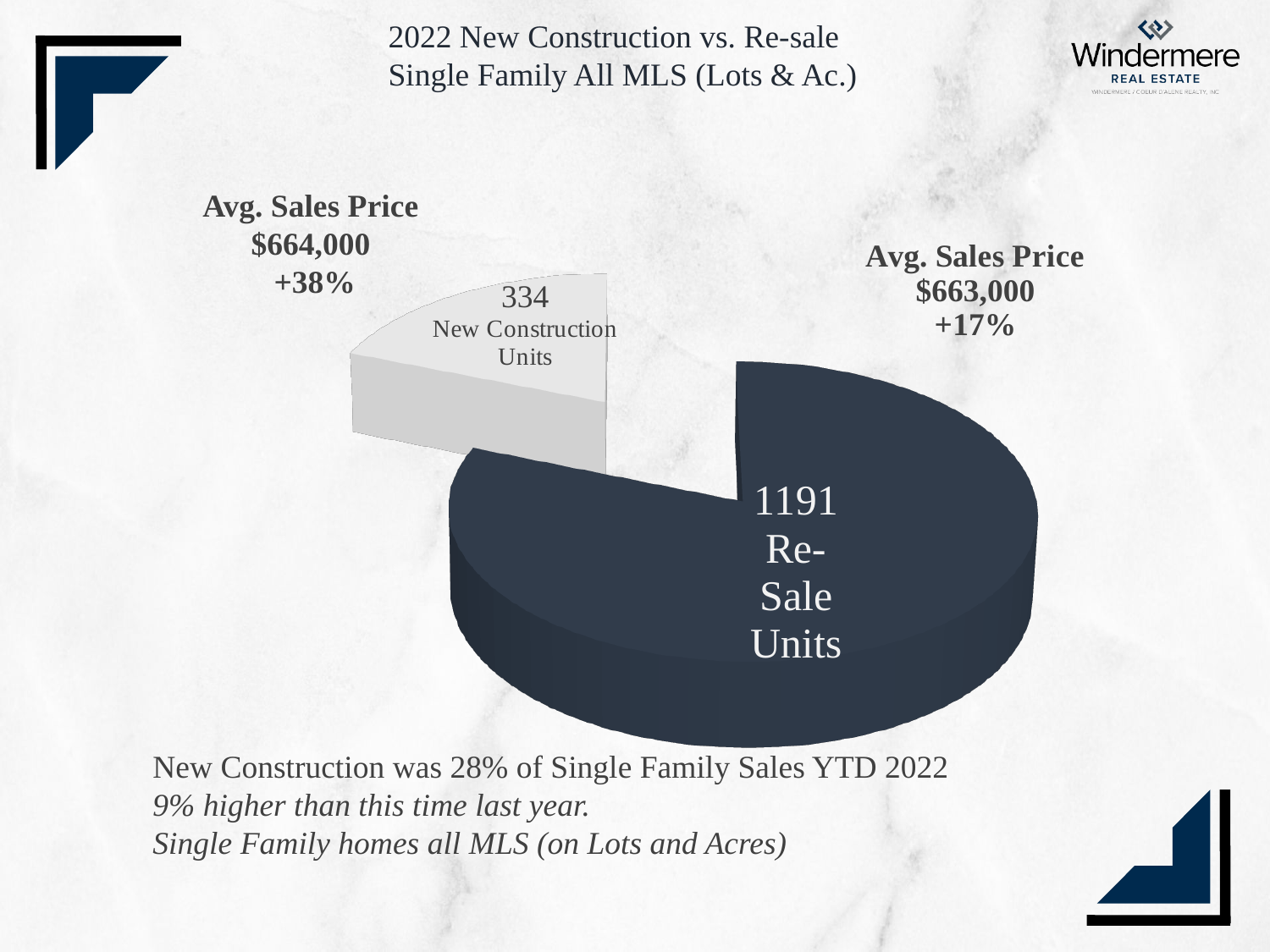
What is the total number of units represented in the pie chart? 1525 How many New Construction Units are shown in the pie chart? 334 What kind of chart is shown on the slide? Pie chart What is the difference between the number of Re-Sale Units and New Construction Units? 857 What is the Avg. Sales Price shown next to the Re-Sale slice? $663,000 What is the title of the chart on the slide? 2022 New Construction vs. Re-sale Single Family All MLS (Lots & Ac.) How many Re-Sale Units are shown in the pie chart? 1191 Which slice of the pie chart is larger, New Construction Units or Re-Sale Units? Re-Sale Units How many slices does the pie chart have? 2 Which category has the smallest slice in the pie chart? New Construction Units What is the Avg. Sales Price shown next to the New Construction slice? $664,000 According to the text below the chart, what percentage of Single Family Sales YTD 2022 was New Construction? 28%